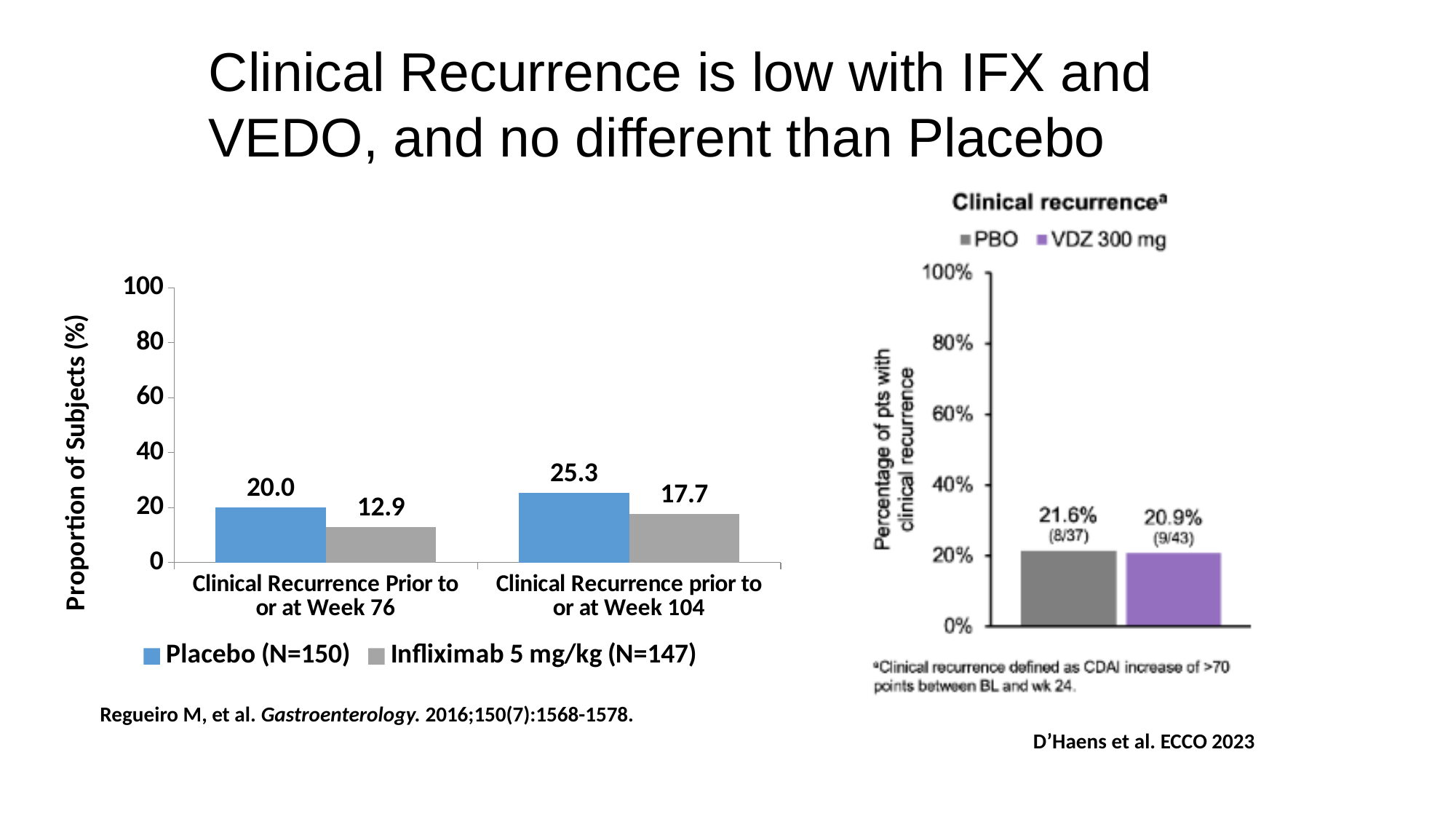
In the left chart, which series has the higher value for Clinical Recurrence prior to or at Week 104? Placebo (N=150) In the Clinical recurrence chart on the right, how many bars are plotted? 2 In the Clinical recurrence chart on the right, what is the value for PBO? 21.6% In the left chart, how many series does the legend list? 2 In the Clinical recurrence chart on the right, what is the difference between the PBO and VDZ 300 mg values? 0.7% In the Clinical recurrence chart on the right, what is the value for VDZ 300 mg? 20.9% In the left chart, does the Placebo value rise or fall from Week 76 to Week 104? rise What kind of chart is the Clinical recurrence chart on the right? bar chart In the left chart, what is the label of the y axis? Proportion of Subjects (%) In the left chart, what is the value for Placebo (N=150) for Clinical Recurrence Prior to or at Week 76? 20.0 In the left chart, what is the value for Infliximab 5 mg/kg (N=147) for Clinical Recurrence prior to or at Week 104? 17.7 In the left chart, what is the difference between the Placebo and Infliximab values for Clinical Recurrence Prior to or at Week 76? 7.1